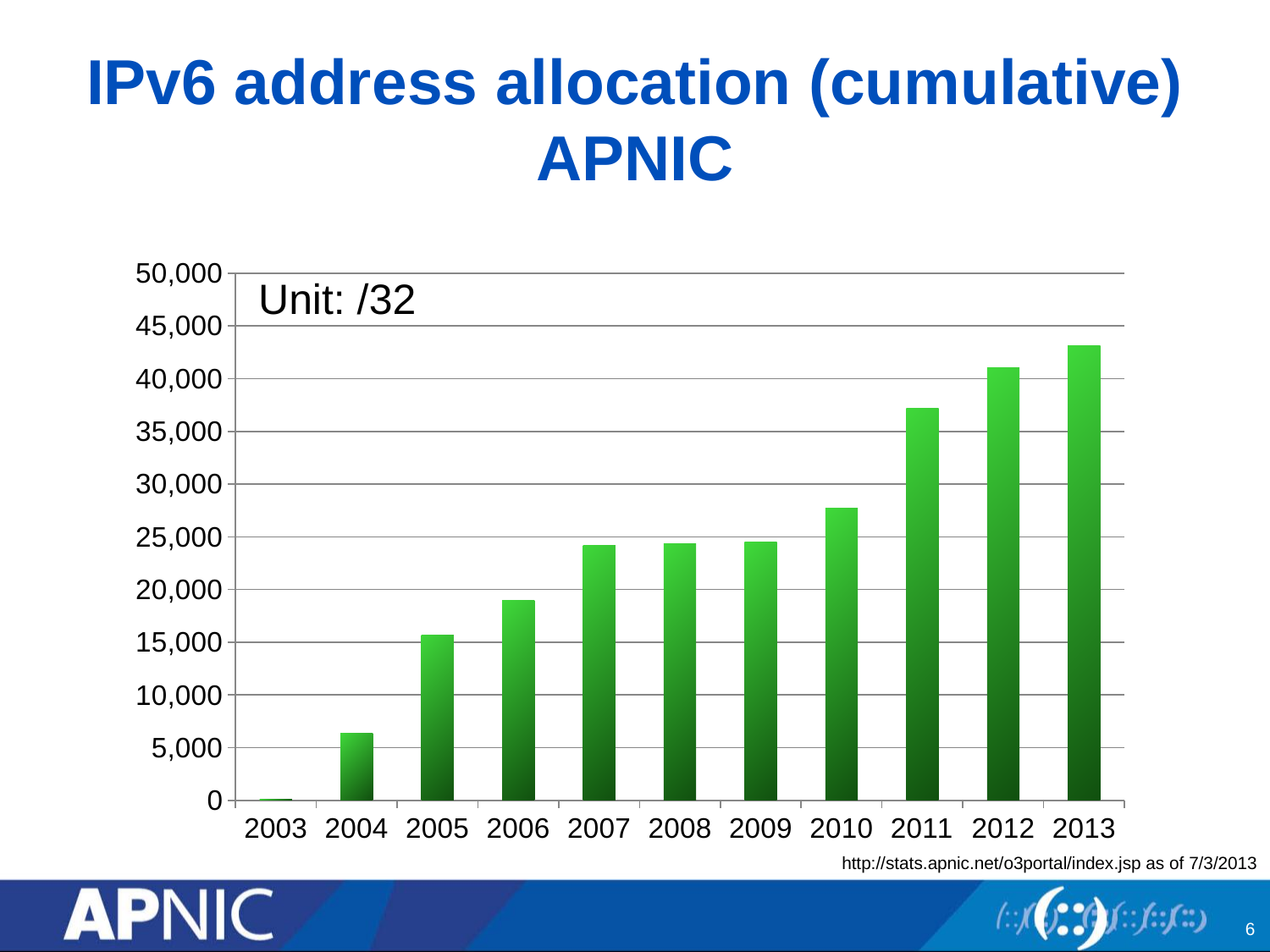
Is the value for 2011 greater or less than 40,000? less Do the values generally rise or fall from 2003 to 2013? rise Is the value for 2006 greater or less than 20,000? less Which year has the highest cumulative IPv6 address allocation? 2013 Which year has the lowest cumulative IPv6 address allocation? 2003 How many years are plotted on the x axis of the chart? 11 Which year has the larger value, 2010 or 2011? 2011 What kind of chart is shown on the slide? bar chart Is the value for 2012 greater or less than 40,000? greater What unit is stated for the values in the chart? /32